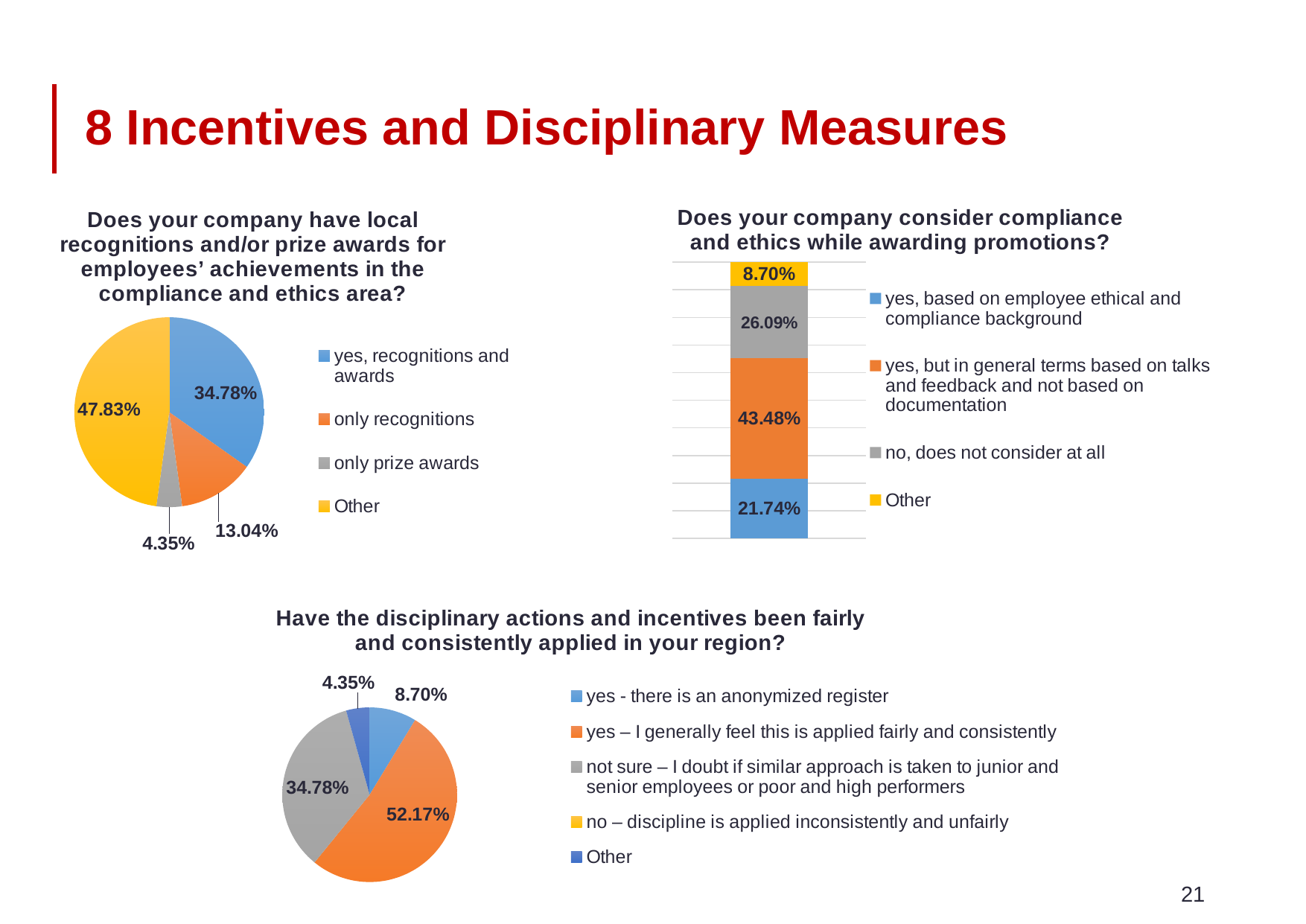
In the chart titled 'Does your company have local recognitions and/or prize awards for employees' achievements in the compliance and ethics area?', what percentage is 'only recognitions'? 13.04% In the chart titled 'Does your company consider compliance and ethics while awarding promotions?', what is the total of the stacked bar? 100.01% In the chart titled 'Does your company have local recognitions and/or prize awards for employees' achievements in the compliance and ethics area?', which category has the largest share? Other In the chart titled 'Does your company have local recognitions and/or prize awards for employees' achievements in the compliance and ethics area?', what is the difference between 'Other' and 'yes, recognitions and awards'? 13.05% What type of chart is used for 'Does your company consider compliance and ethics while awarding promotions?'? Stacked bar chart In the chart titled 'Does your company have local recognitions and/or prize awards for employees' achievements in the compliance and ethics area?', which category has the smallest share? only prize awards In the chart titled 'Does your company consider compliance and ethics while awarding promotions?', which category has the largest value? yes, but in general terms based on talks and feedback and not based on documentation In the chart titled 'Does your company consider compliance and ethics while awarding promotions?', how many series does the legend list? 4 In the chart titled 'Have the disciplinary actions and incentives been fairly and consistently applied in your region?', which is larger: 'yes - there is an anonymized register' or 'Other'? yes - there is an anonymized register In the chart titled 'Does your company consider compliance and ethics while awarding promotions?', what percentage is 'no, does not consider at all'? 26.09% In the chart titled 'Have the disciplinary actions and incentives been fairly and consistently applied in your region?', how many entries does the legend list? 5 In the chart titled 'Have the disciplinary actions and incentives been fairly and consistently applied in your region?', what percentage is 'not sure – I doubt if similar approach is taken to junior and senior employees or poor and high performers'? 34.78%